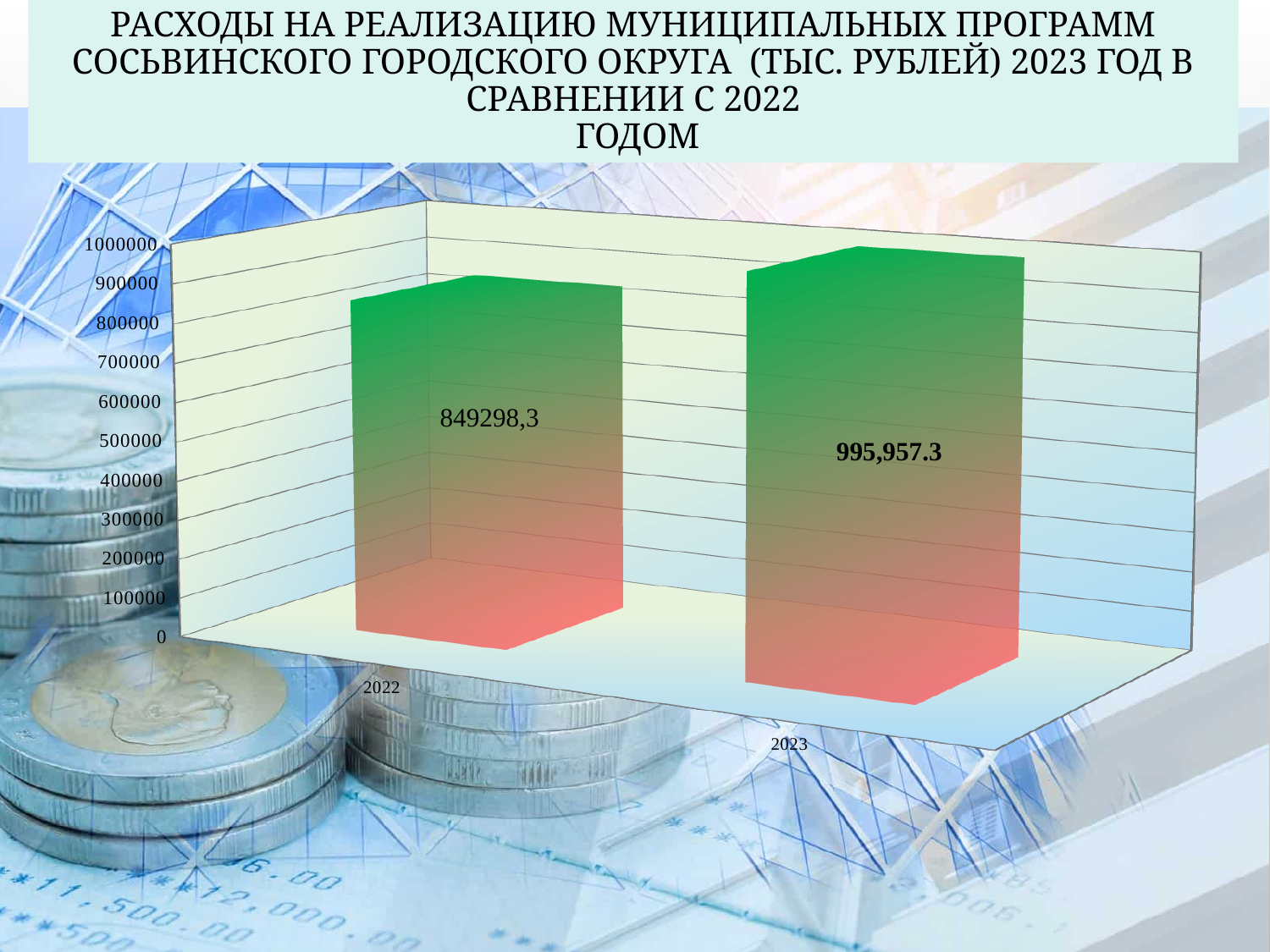
What kind of chart is shown on the slide? bar chart How many categories (years) are shown on the chart? 2 Is the value for 2022 greater or less than 800000? greater In what units are the values on the chart expressed, according to the title? тыс. рублей What is the highest value shown on the vertical axis? 1000000 Which year has the higher value? 2023 Do the values rise or fall from 2022 to 2023? rise What is the value for 2023? 995,957.3 Which year has the lower value? 2022 Is the value for 2023 larger or smaller than the value for 2022? larger What is the value for 2022? 849298,3 Is the value for 2023 greater or less than 1000000? less